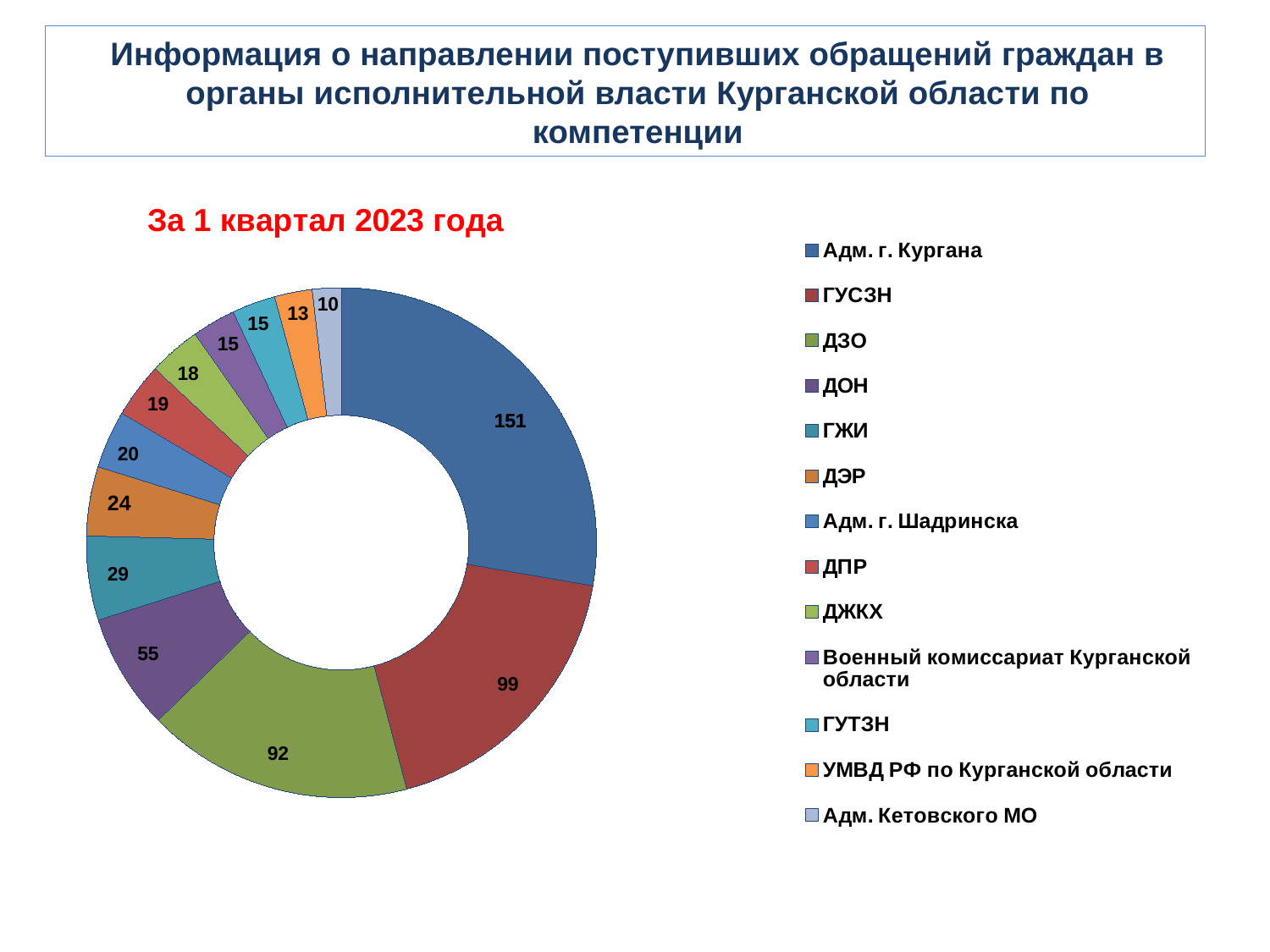
What is the value for Адм. г. Кургана? 151 What is the difference between the values for ДЗО and ДОН? 37 What is the value for Адм. Кетовского МО? 10 How many categories does the legend list? 13 Which is larger, the value for ГЖИ or the value for ДЭР? ГЖИ What is the difference between the values for Адм. г. Кургана and ГУСЗН? 52 What is the value for ГУСЗН? 99 What type of chart is shown on the slide? doughnut chart What period does the chart's subtitle refer to? За 1 квартал 2023 года Which category has the lowest value? Адм. Кетовского МО What is the value for ДОН? 55 Which category has the highest value? Адм. г. Кургана